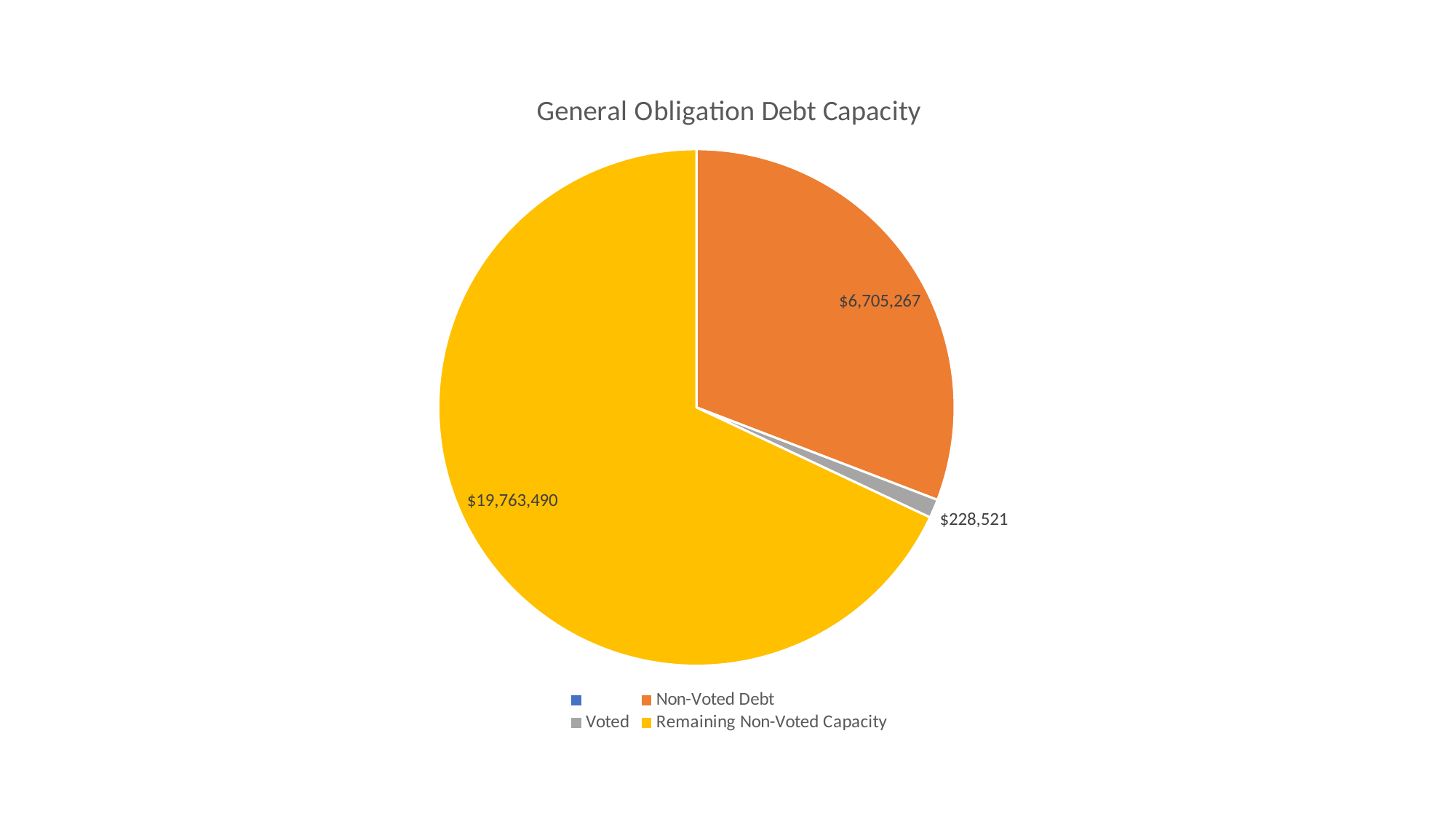
Which slice is the largest? Remaining Non-Voted Capacity What is the difference between the Remaining Non-Voted Capacity and Non-Voted Debt values? $13,058,223 What is the difference between the Non-Voted Debt and Voted values? $6,476,746 Which is larger, Non-Voted Debt or Voted? Non-Voted Debt What type of chart is shown on the slide? Pie chart What colour is the Remaining Non-Voted Capacity slice? Yellow What is the value of the Remaining Non-Voted Capacity slice? $19,763,490 How many slices with data labels are shown in the pie? 3 What is the title of the chart? General Obligation Debt Capacity What is the value of the Non-Voted Debt slice? $6,705,267 What is the value of the Voted slice? $228,521 Which labelled slice is the smallest? Voted